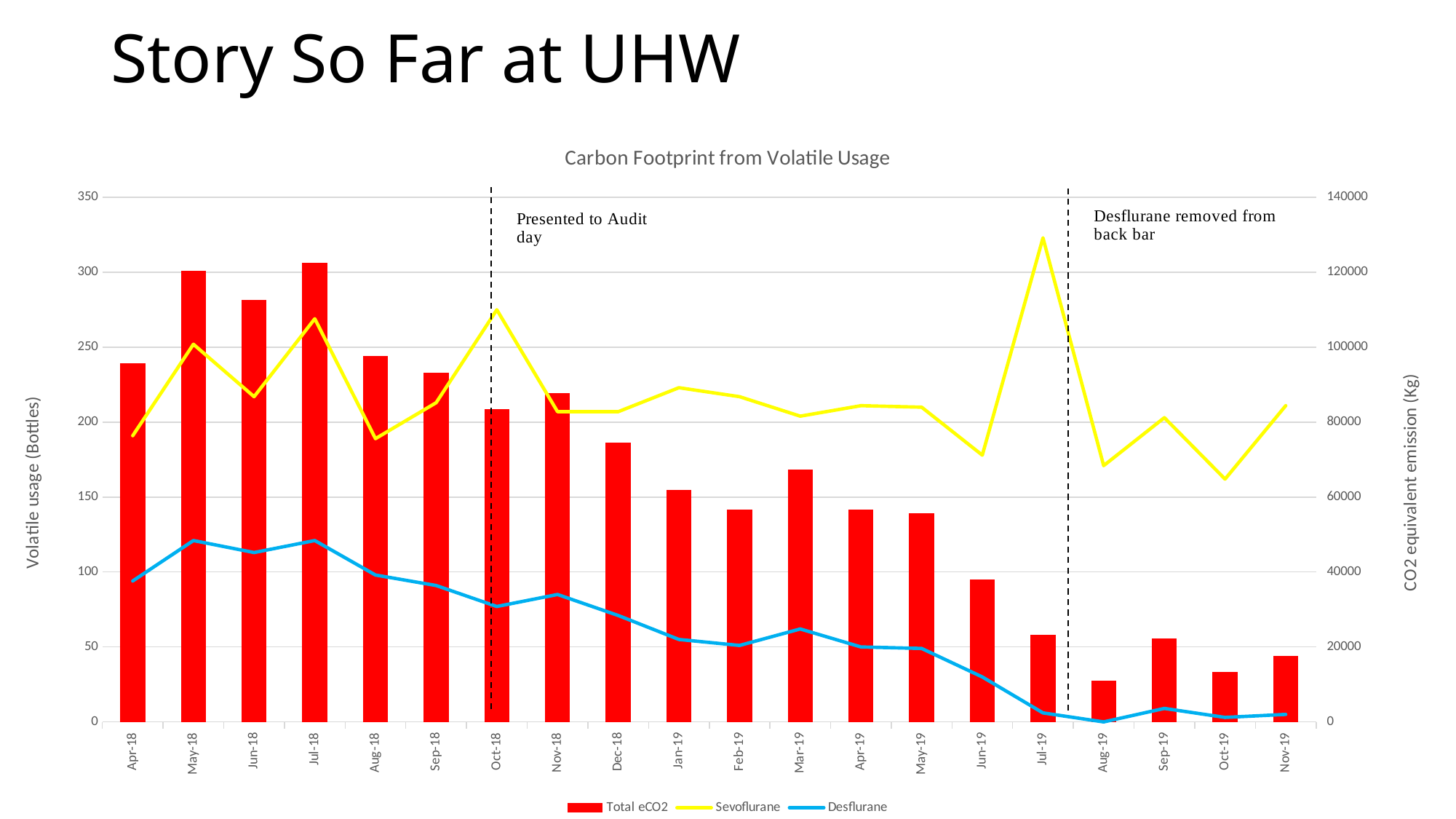
Overall, does the Desflurane line rise or fall from Apr-18 to Nov-19? fall Which is larger, the Sevoflurane value for Jun-19 or for Jul-19? Jul-19 In which month does the Sevoflurane line reach its highest value? Jul-19 What kind of chart is this? Combined bar and line chart Which is larger, the Total eCO2 bar for Apr-18 or for May-18? May-18 How many months are shown along the x axis of the chart? 20 How many series does the chart legend list? 3 Is the Total eCO2 bar for Jul-18 greater or less than 250? greater What is the title of the chart? Carbon Footprint from Volatile Usage What is the label of the left vertical axis? Volatile usage (Bottles)